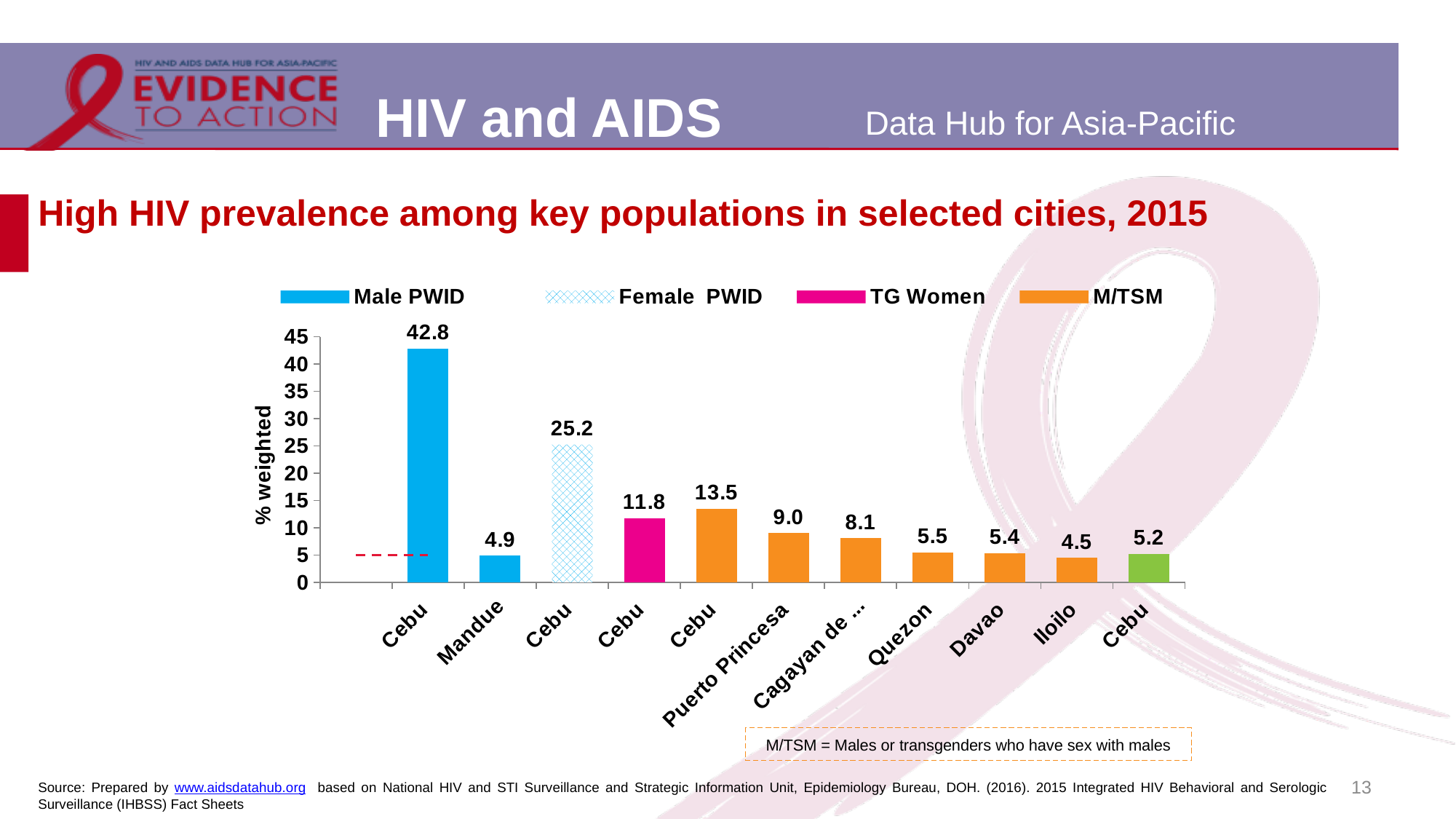
What is the difference between the Male PWID value in Cebu and the Female PWID value in Cebu? 17.6 What is the value for Male PWID in Cebu? 42.8 What is the value for Male PWID in Mandue? 4.9 What is the value for TG Women in Cebu? 11.8 How many series does the legend list? 4 What is the value for Female PWID in Cebu? 25.2 Which bar has the lowest value on the chart? Iloilo, 4.5 Which is larger, the M/TSM value for Quezon or for Davao? Quezon What is the value for M/TSM in Iloilo? 4.5 Which bar has the highest value on the chart? Cebu (Male PWID), 42.8 What is the value for M/TSM in Puerto Princesa? 9.0 What kind of chart is shown on the slide? Bar chart